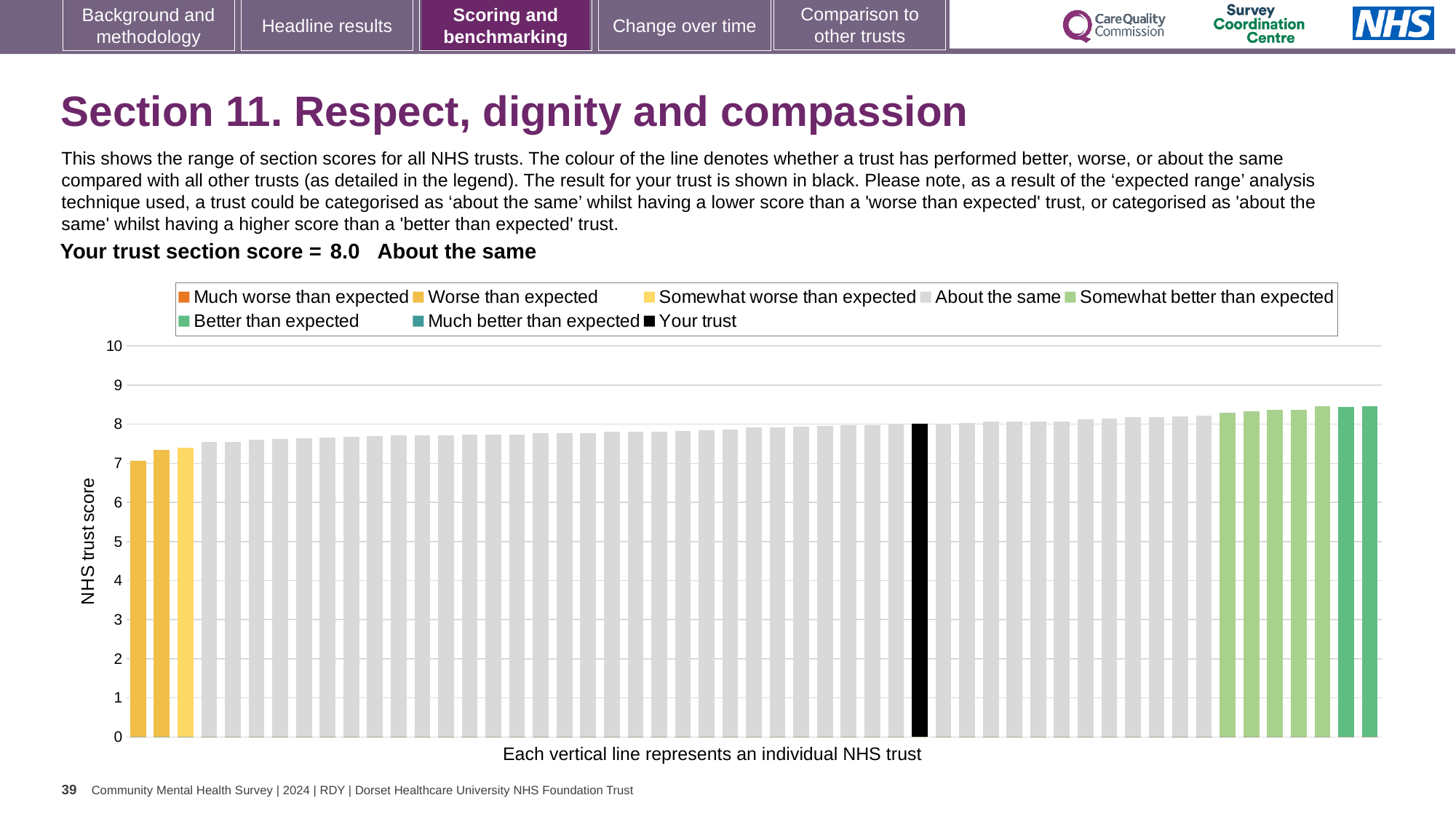
Do the bar values rise or fall from left to right along the x axis? rise What colour is the bar representing your trust? black How many yellow-shaded bars appear to the left of the grey bars? 3 How many entries does the chart legend list? 8 Is the value of the leftmost (lowest) bar greater or less than 8? less Is the value of the rightmost (highest) bar greater or less than 8? greater Is the value of the rightmost bar greater or less than 9? less Which bar is taller, the leftmost bar or the rightmost bar? the rightmost bar What is the section score for your trust shown on the slide? 8.0 What type of chart is shown on the slide? bar chart What is the label on the vertical axis of the chart? NHS trust score Which category does your trust's section score fall into according to the slide? About the same